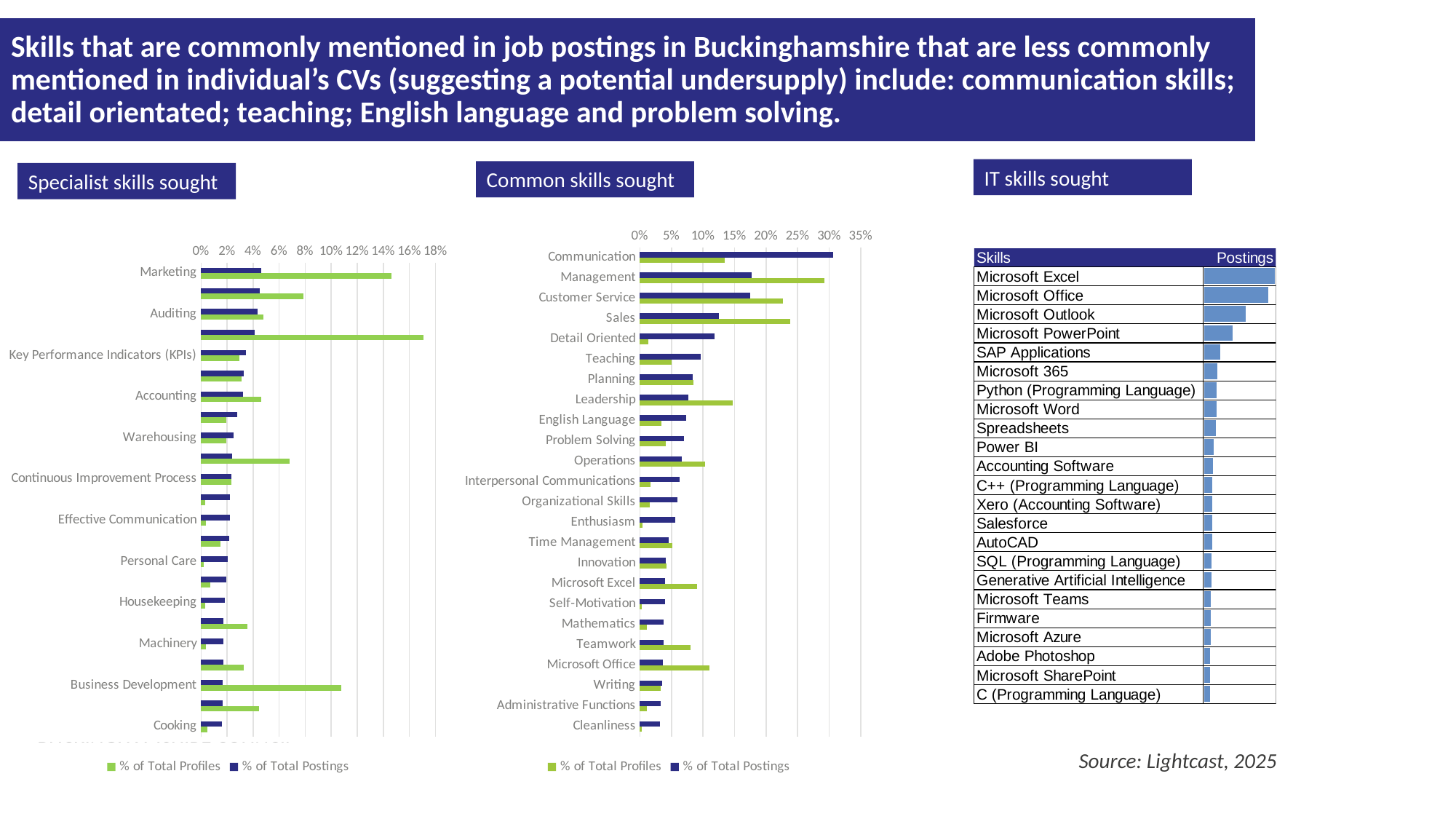
In the 'Common skills sought' chart, is the % of Total Profiles for Detail Oriented greater or less than 5%? less What are the two legend entries of the 'Specialist skills sought' chart? % of Total Profiles and % of Total Postings In the 'Common skills sought' chart, is the % of Total Postings for Communication greater or less than 25%? greater In the 'Common skills sought' chart, for Microsoft Office, which is larger: % of Total Profiles or % of Total Postings? % of Total Profiles In the 'Common skills sought' chart, which skill has the highest % of Total Postings? Communication How many series does the legend of the 'Common skills sought' chart list? 2 How many skills are listed on the y axis of the 'Common skills sought' chart? 24 In the 'Common skills sought' chart, for Teaching, which is larger: % of Total Postings or % of Total Profiles? % of Total Postings In the 'Common skills sought' chart, is the % of Total Postings for Management greater or less than 10%? greater In the 'Common skills sought' chart, which skill has the highest % of Total Profiles? Management What kind of chart is the 'Specialist skills sought' chart? bar chart